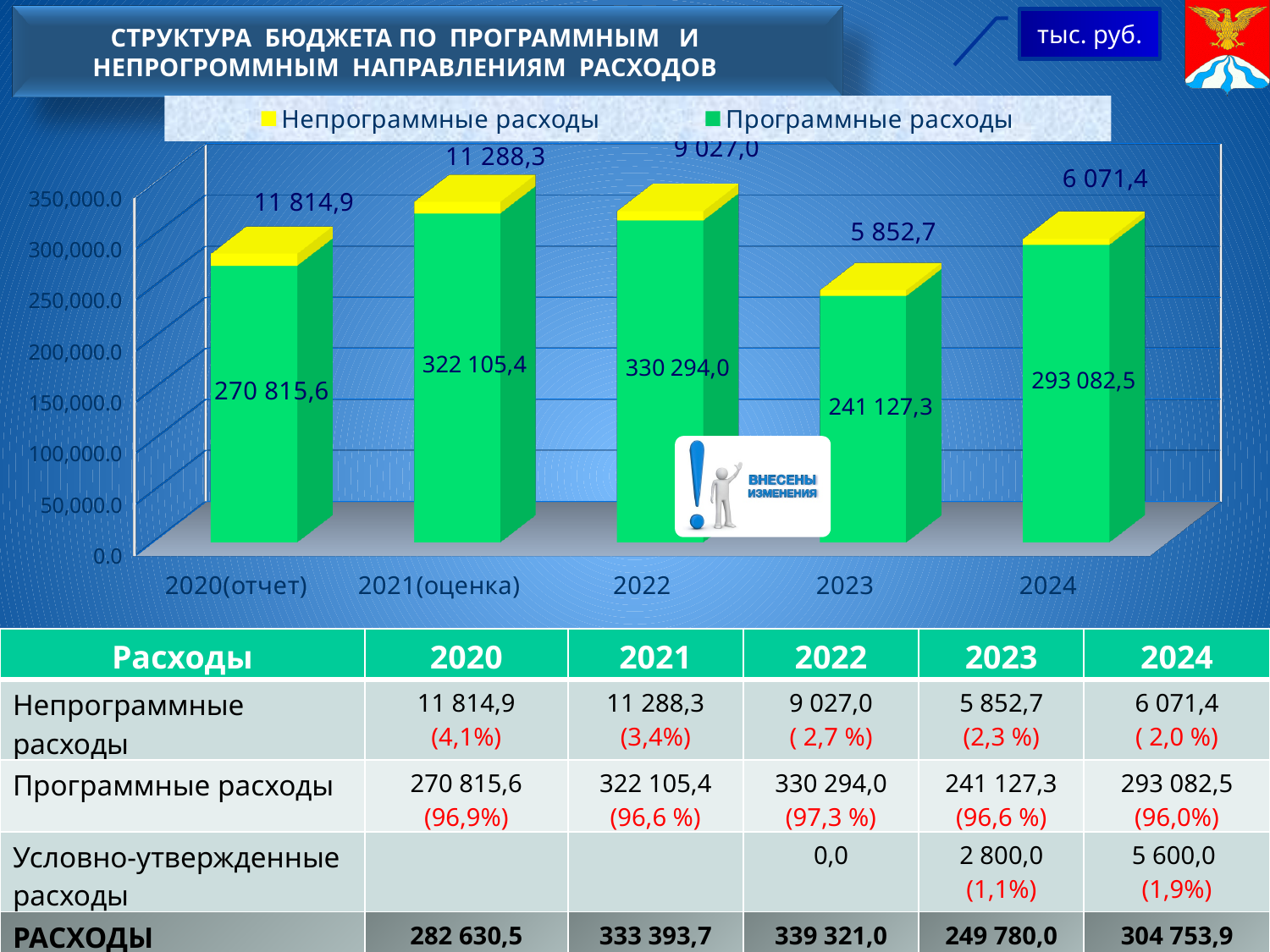
What is the value of Программные расходы for 2022? 330 294,0 How many series does the chart legend list? 2 Which is larger: Непрограммные расходы in 2023 or in 2024? 2024 Is the value of Программные расходы for 2022 greater or less than 300,000.0? greater Which year has the highest value of Программные расходы? 2022 What is the value of Программные расходы for 2024? 293 082,5 What is the total of the stacked bar for 2020(отчет)? 282 630,5 What is the difference between Программные расходы in 2022 and in 2021(оценка)? 8 188,6 Which year has the lowest value of Непрограммные расходы? 2023 How many years are shown on the x axis of the chart? 5 What kind of chart is shown on the slide? Stacked bar chart What is the value of Непрограммные расходы for 2020(отчет)? 11 814,9